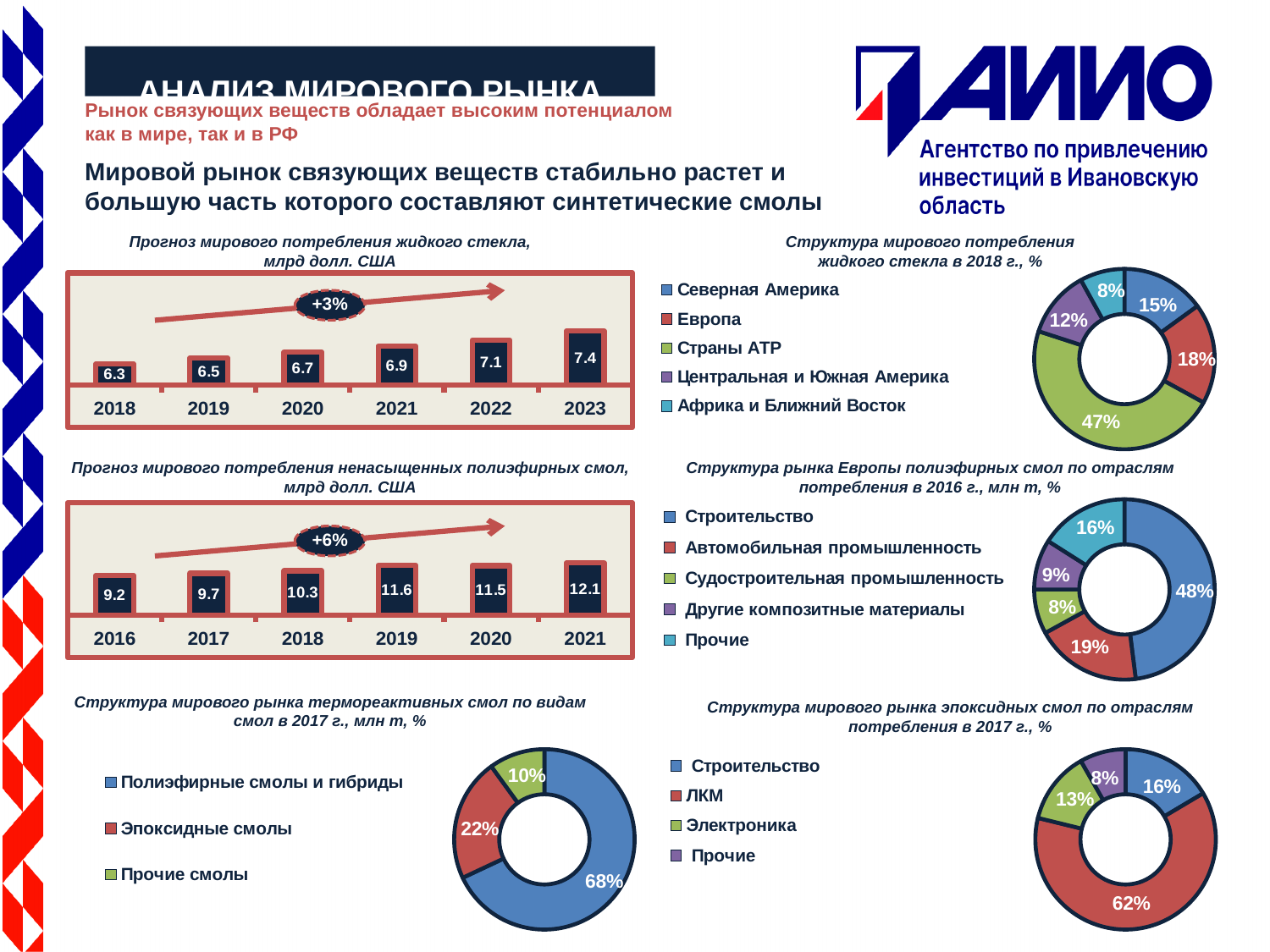
In the chart 'Прогноз мирового потребления ненасыщенных полиэфирных смол, млрд долл. США', what is the value for 2019? 11.6 In the chart 'Структура рынка Европы полиэфирных смол по отраслям потребления в 2016 г., млн т, %', which category has the smallest share? Судостроительная промышленность In the chart 'Структура рынка Европы полиэфирных смол по отраслям потребления в 2016 г., млн т, %', what is the share of Автомобильная промышленность? 19% What type of chart is 'Прогноз мирового потребления ненасыщенных полиэфирных смол, млрд долл. США'? Bar chart In the chart 'Структура мирового рынка термореактивных смол по видам смол в 2017 г., млн т, %', how many categories does the legend list? 3 In the chart 'Структура мирового потребления жидкого стекла в 2018 г., %', which region has the largest share? Страны АТР In the chart 'Прогноз мирового потребления ненасыщенных полиэфирных смол, млрд долл. США', which is larger, the value for 2019 or the value for 2020? 2019 In the chart 'Структура мирового рынка эпоксидных смол по отраслям потребления в 2017 г., %', what is the share of ЛКМ? 62% In the chart 'Прогноз мирового потребления жидкого стекла, млрд долл. США', how many years are shown on the x axis? 6 In the chart 'Структура мирового потребления жидкого стекла в 2018 г., %', what is the share of Европа? 18% In the chart 'Прогноз мирового потребления жидкого стекла, млрд долл. США', what is the value for 2023? 7.4 In the chart 'Прогноз мирового потребления жидкого стекла, млрд долл. США', what is the difference between the 2023 and 2018 values? 1.1